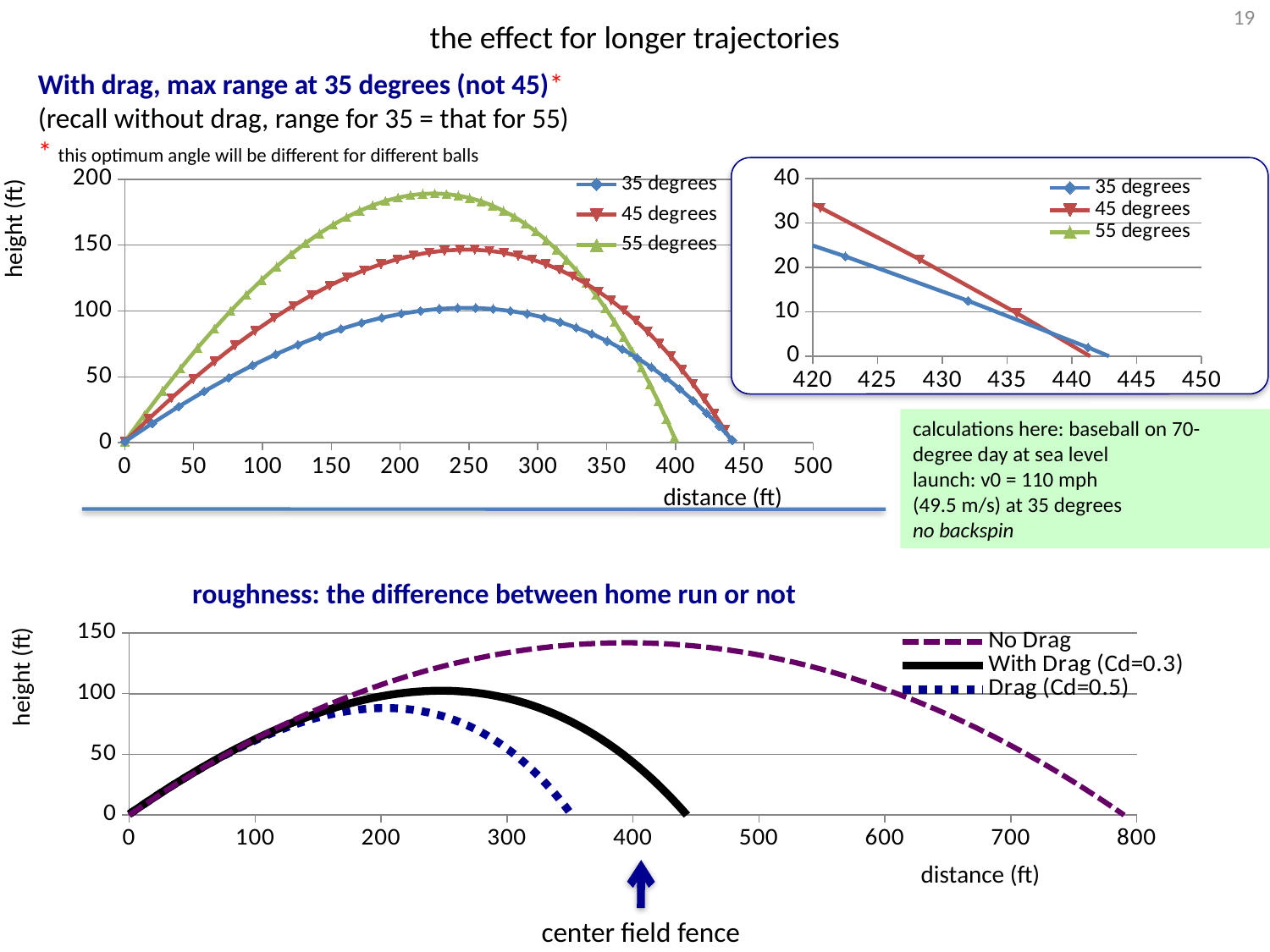
In the bottom chart, which series travels the farthest horizontal distance? No Drag What type of chart is the top-left chart? line chart In the bottom chart, how many series does the legend list? 3 What is the x-axis label of the bottom chart? distance (ft) In the top-left chart, is the peak height of the 45 degrees series greater or less than 100? greater In the top-left chart, which series returns to zero height at the shortest distance? 55 degrees In the top-left chart, how many series does the legend list? 3 In the top-left chart, which series has the lowest peak height? 35 degrees In the bottom chart, is the peak height of the Drag (Cd=0.5) series greater or less than 100? less In the top-left chart, which series reaches the greatest maximum height? 55 degrees In the top-left chart, is the peak height of the 55 degrees series greater or less than 150? greater